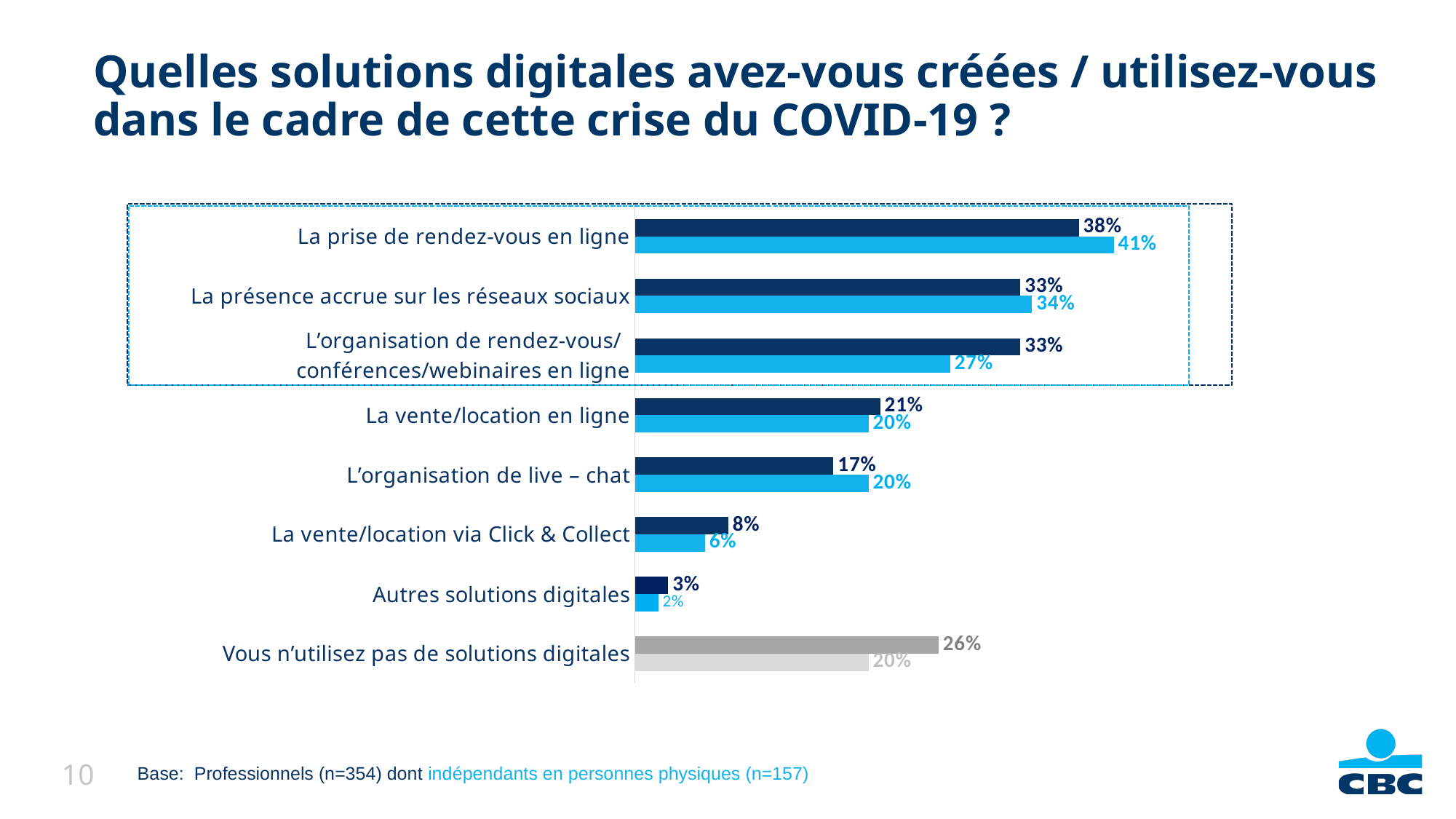
Which category has the highest light blue value? La prise de rendez-vous en ligne What is the light blue value for 'La prise de rendez-vous en ligne'? 41% What type of chart is shown on the slide? bar chart What is the dark blue value for 'La vente/location via Click & Collect'? 8% What is the sample size of 'Professionnels' given in the base note below the chart? n=354 What is the difference between the dark blue and light blue values for 'L'organisation de rendez-vous/conférences/webinaires en ligne'? 6% For 'L'organisation de live – chat', which is larger: the dark blue value or the light blue value? the light blue value What is the dark grey value for 'Vous n'utilisez pas de solutions digitales'? 26% What is the light blue value for 'L'organisation de rendez-vous/conférences/webinaires en ligne'? 27% Which category has the lowest dark blue value? Autres solutions digitales What is the dark blue value for 'La prise de rendez-vous en ligne'? 38% How many categories are listed on the chart? 8